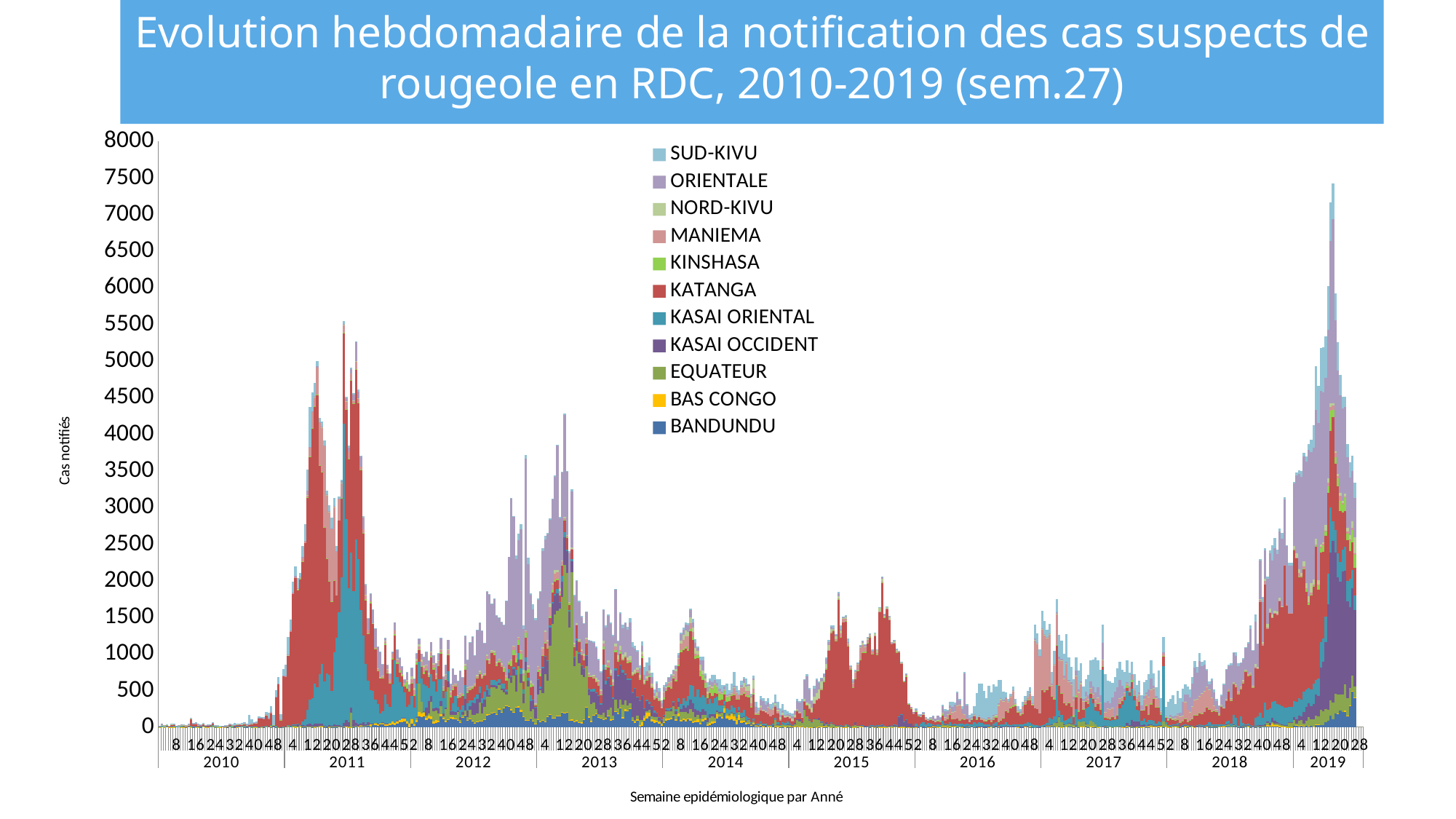
What is the title of the chart? Evolution hebdomadaire de la notification des cas suspects de rougeole en RDC, 2010-2019 (sem.27) How many years are shown along the x axis? 10 What kind of chart is shown on the slide? Stacked bar chart In which year does the weekly total of notified cases reach its highest peak? 2019 Is the highest weekly total in 2019 greater or less than 7000? greater From 2016 to 2019, do the peak weekly totals rise or fall? rise Is the highest weekly total in 2014 greater or less than 2000? less Which year has the higher peak of weekly notified cases, 2011 or 2013? 2011 How many series does the legend list? 11 Is the highest weekly total in 2016 greater or less than 1000? less What is the label of the vertical axis? Cas notifiés